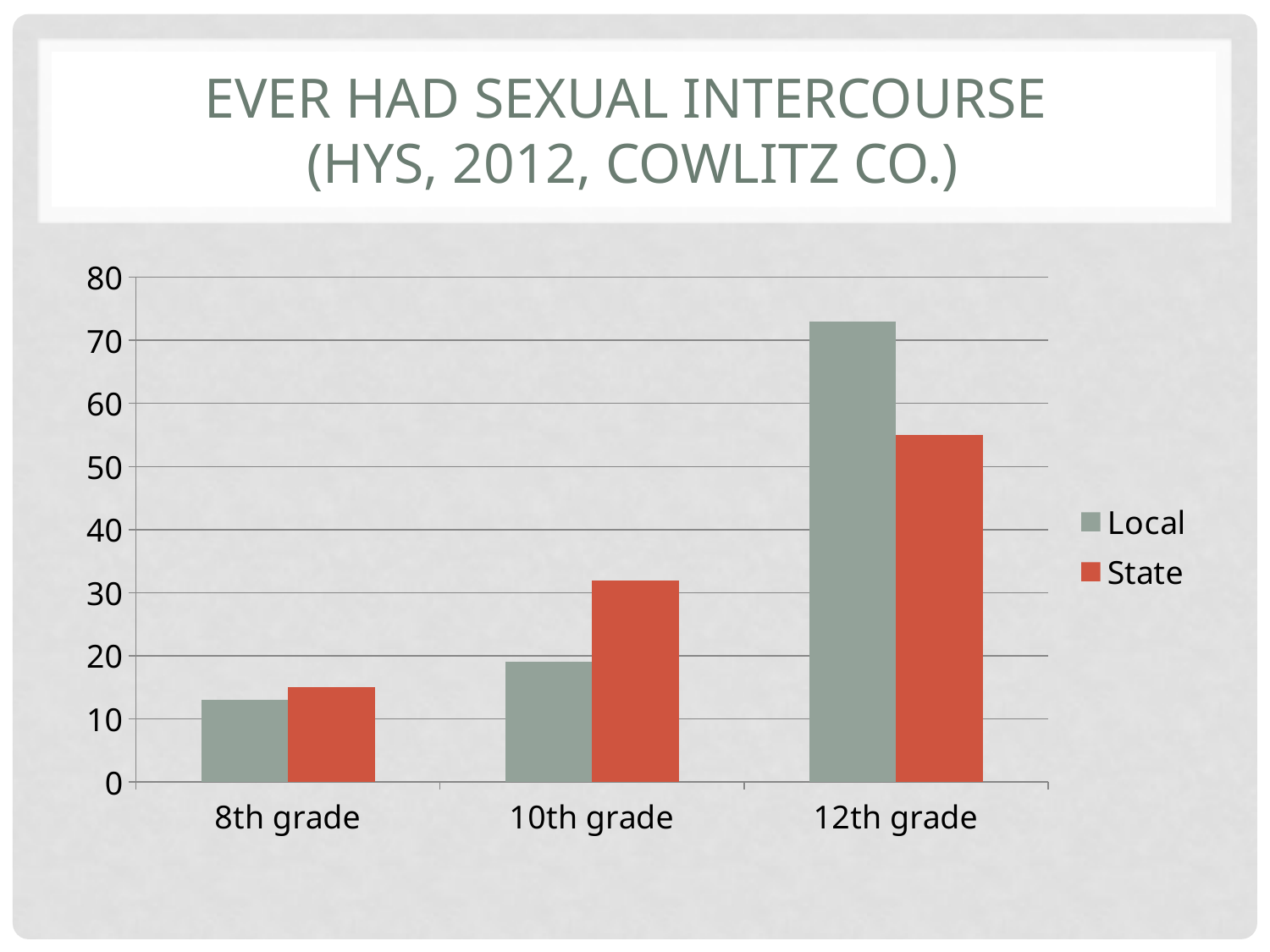
How many series does the legend list? 2 Which grade has the lowest State value? 8th grade Is the State value for 10th grade greater or less than 20? greater For 10th grade, which is larger, the Local value or the State value? State What kind of chart is shown on the slide? bar chart Which grade has the highest Local value? 12th grade How many grade categories are shown on the x axis? 3 Do the Local values rise or fall from 8th grade to 12th grade? rise Is the Local value for 12th grade greater or less than 60? greater Is the State value for 12th grade greater or less than 60? less For 12th grade, which is larger, the Local value or the State value? Local What colour are the State bars? red